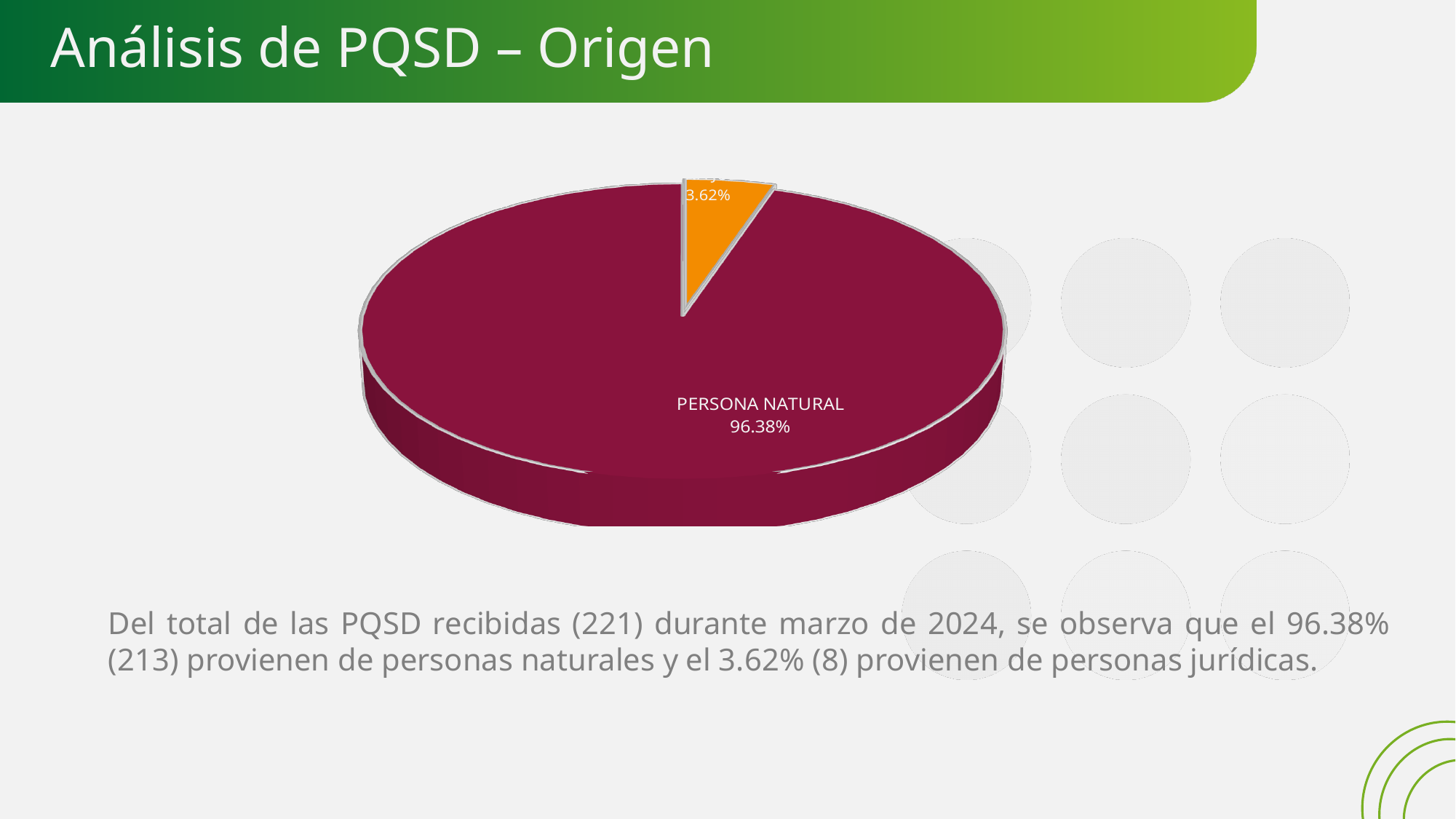
What colour is the PERSONA NATURAL slice? dark magenta (burgundy) Which slice of the pie is the largest? PERSONA NATURAL What is the title of the slide containing the pie chart? Análisis de PQSD – Origen Is the value of the orange slice greater or less than 10%? less What is the difference in percentage points between the PERSONA NATURAL slice and the 3.62% slice? 92.76 How many slices does the pie chart have? 2 What kind of chart is shown on the slide? pie chart Which is larger, the PERSONA NATURAL slice or the orange slice? PERSONA NATURAL What percentage is shown on the small orange slice of the pie? 3.62% Is the share for PERSONA NATURAL greater or less than 90%? greater What share of the pie does PERSONA NATURAL represent? 96.38%